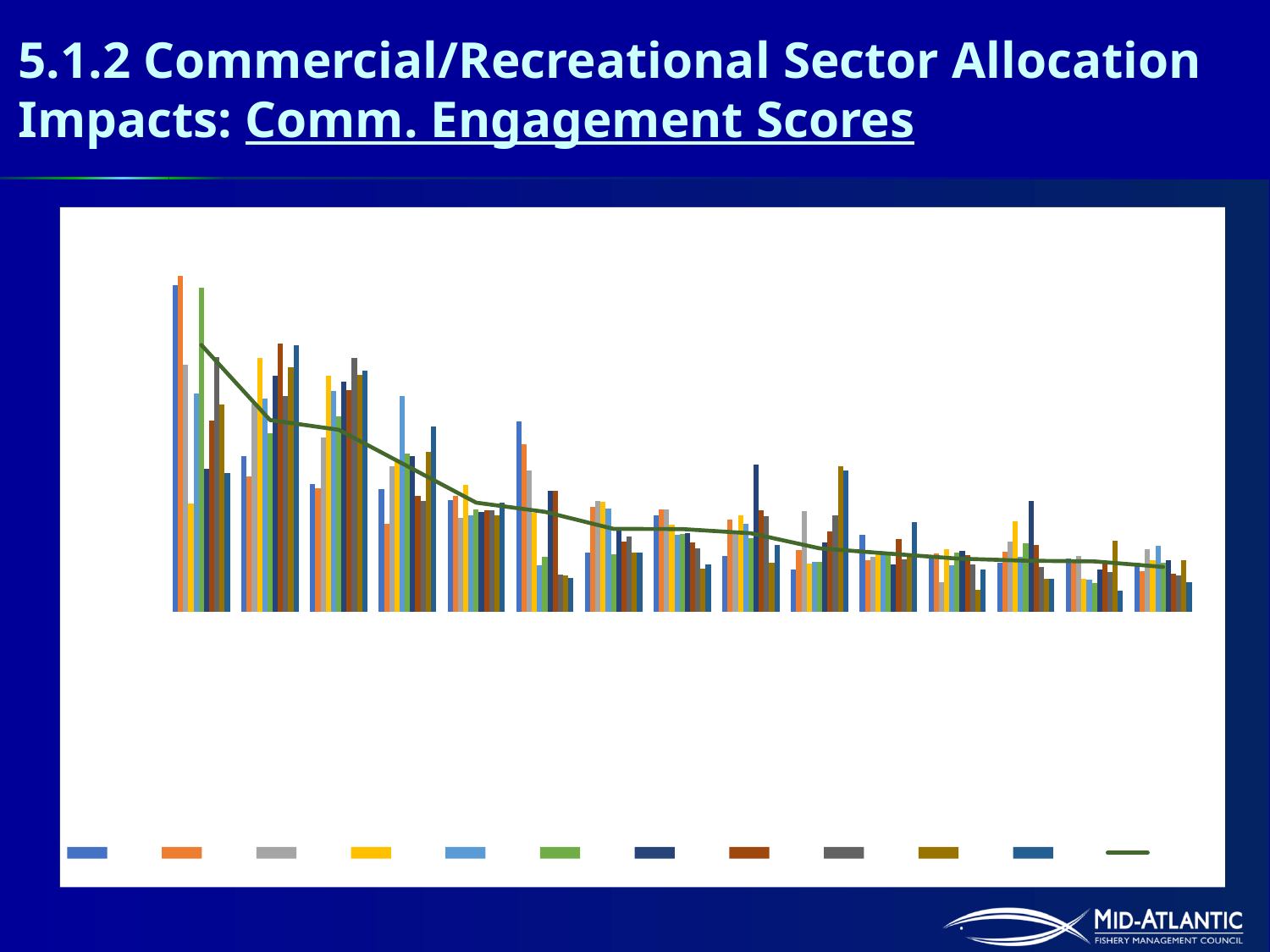
What colour is the line plotted across the bars? green Does the green line on the chart generally rise or fall from left to right? fall What kind of chart is shown on the slide? bar chart with a line overlay Do the legend entries on the chart have readable text labels? No How many of the legend entries are bar series (as opposed to the line series)? 11 How many groups of bars are plotted along the x axis of the chart? 15 How many entries does the legend at the bottom of the chart show? 12